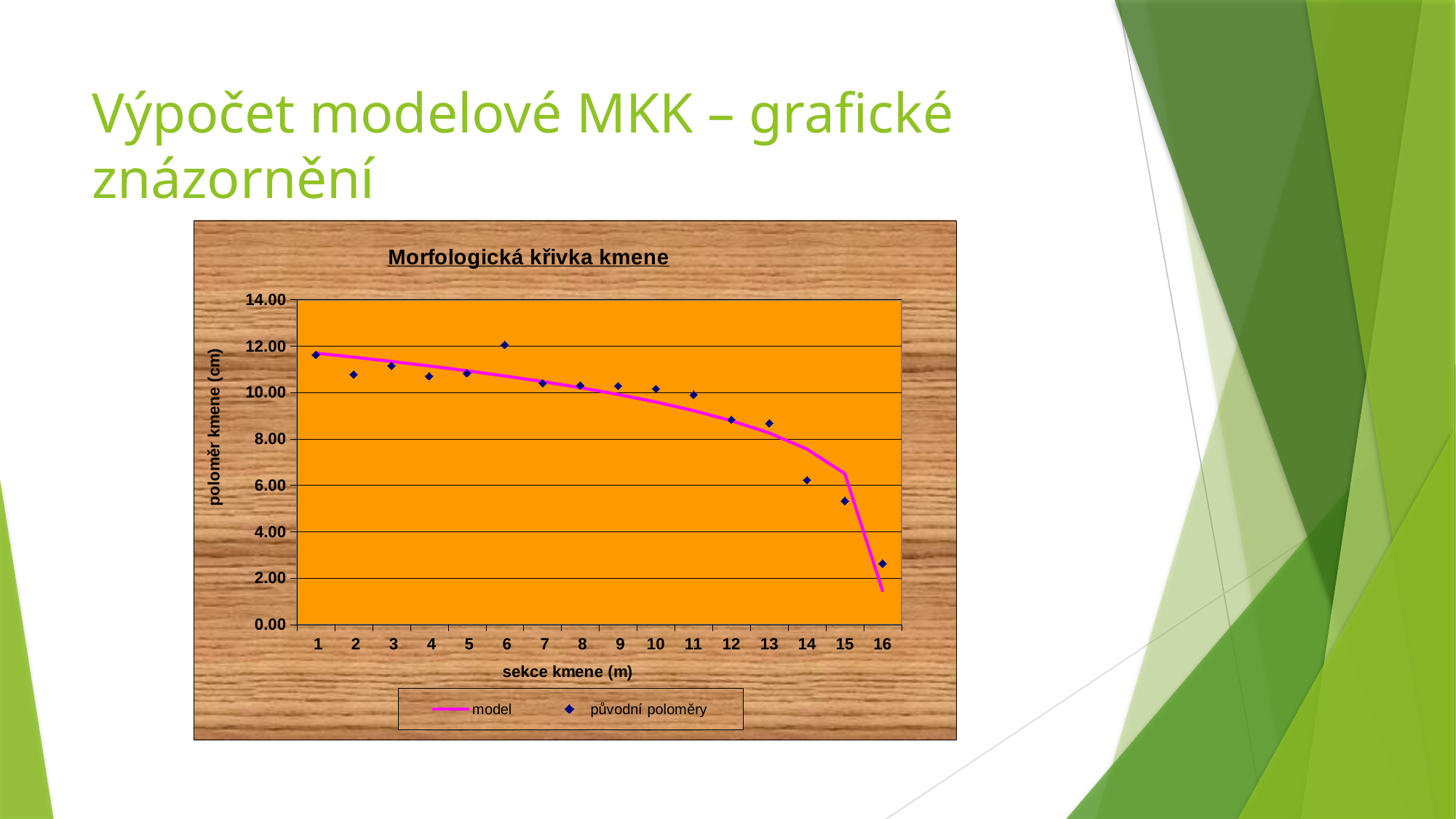
Is the původní poloměry value at section 1 greater or less than 10.00? greater What are the names of the two series in the legend? model, původní poloměry What kind of chart is shown? line chart Is the původní poloměry value at section 14 greater or less than 8.00? less How many series does the chart legend list? 2 Do the values of the model series rise or fall as the section number increases along the x axis? fall Is the původní poloměry value at section 16 greater or less than 4.00? less What is the title of the chart? Morfologická křivka kmene At which section is the původní poloměry value lowest? 16 How many sections (sekce kmene) are shown along the x axis? 16 At which section is the původní poloměry value highest? 6